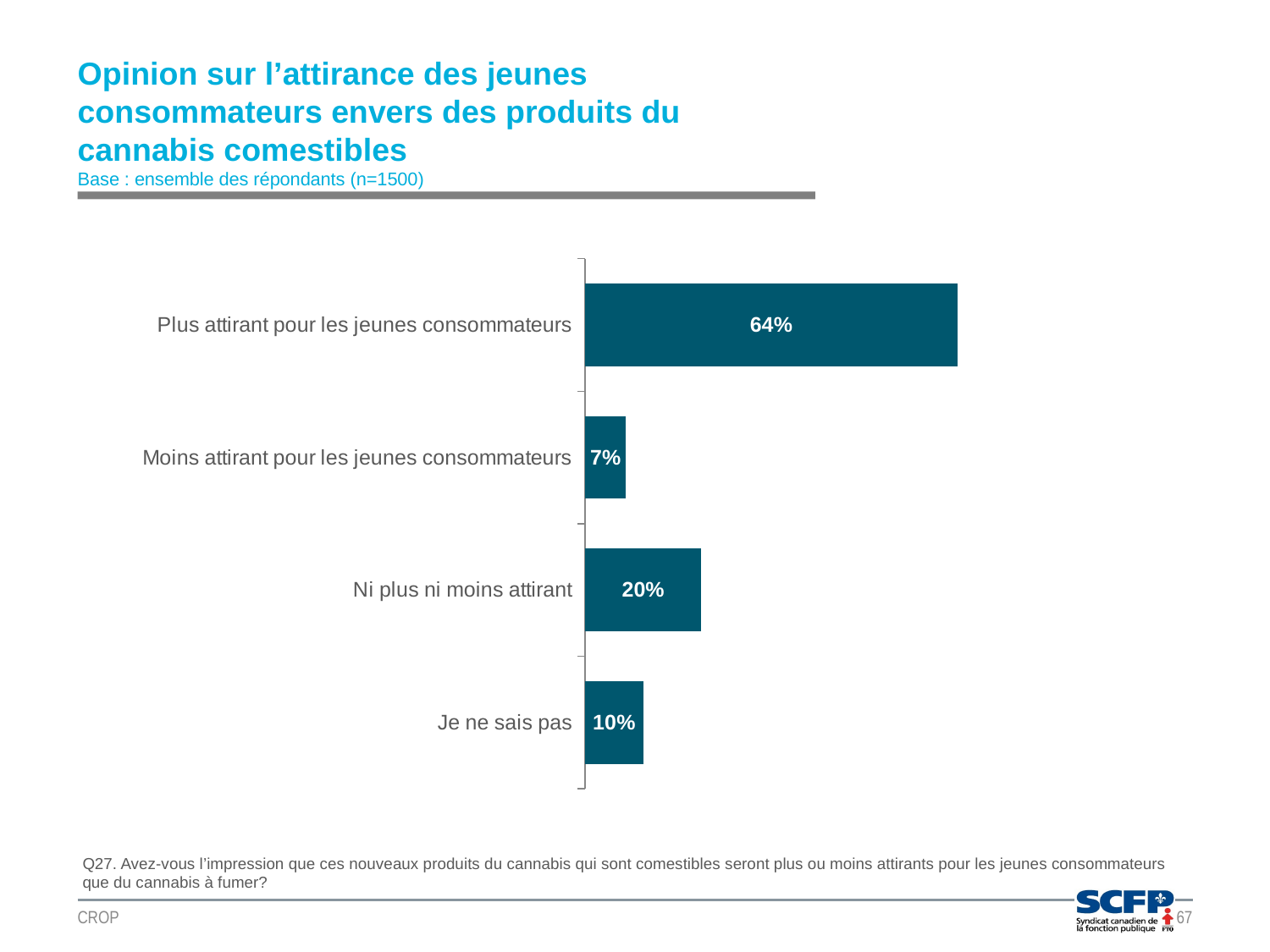
What percentage of respondents answered 'Je ne sais pas'? 10% What is the difference between 'Ni plus ni moins attirant' and 'Je ne sais pas'? 10% Which category has the lowest value? Moins attirant pour les jeunes consommateurs What kind of chart is shown on the slide? Bar chart What percentage of respondents said edible cannabis products are 'Plus attirant pour les jeunes consommateurs'? 64% Which category has the highest value? Plus attirant pour les jeunes consommateurs Which is larger: 'Je ne sais pas' or 'Moins attirant pour les jeunes consommateurs'? Je ne sais pas What is the value for 'Ni plus ni moins attirant'? 20% What is the value for 'Moins attirant pour les jeunes consommateurs'? 7% What is the base (number of respondents) stated under the chart title? n=1500 How many categories are shown in the chart? 4 What is the difference between 'Plus attirant pour les jeunes consommateurs' and 'Ni plus ni moins attirant'? 44%